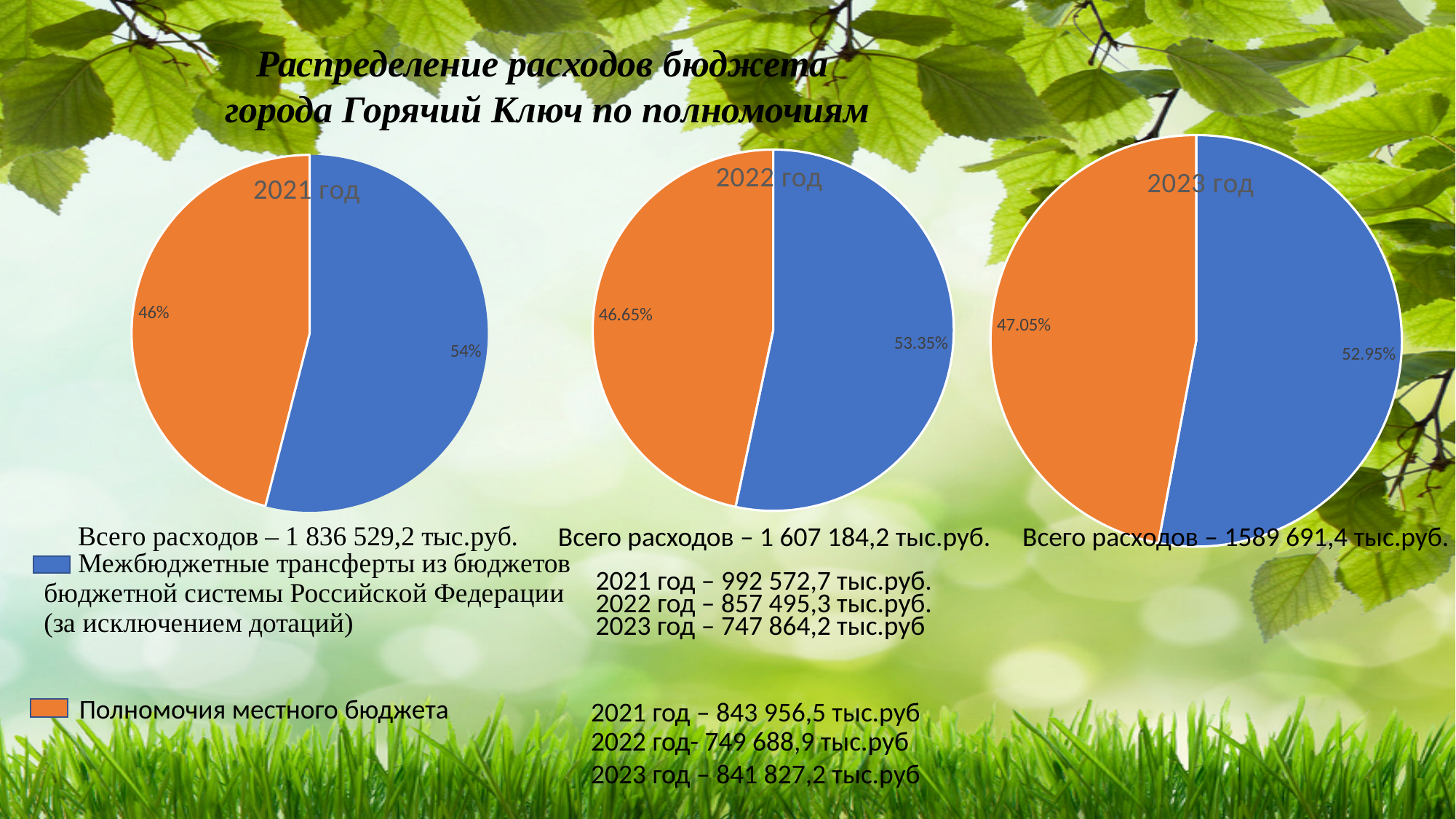
In the "2023 год" chart, what share is shown for the orange slice (Полномочия местного бюджета)? 47.05% In the "2022 год" chart, what share is shown for the orange slice (Полномочия местного бюджета)? 46.65% What kind of chart is used for the "2021 год" chart? pie chart In the "2022 год" chart, what share is shown for the blue slice (Межбюджетные трансферты)? 53.35% In the "2022 год" chart, what is the difference between the blue slice (53.35%) and the orange slice (46.65%)? 6.70% In the "2021 год" chart, what share is shown for the blue slice (Межбюджетные трансферты из бюджетов бюджетной системы Российской Федерации)? 54% In the "2023 год" chart, what share is shown for the blue slice (Межбюджетные трансферты)? 52.95% In the "2021 год" chart, which slice is the largest? Межбюджетные трансферты из бюджетов бюджетной системы Российской Федерации (54%) In the "2023 год" chart, which slice is the smallest? Полномочия местного бюджета (47.05%) How many pie charts are shown on the slide? 3 How many slices does the "2022 год" pie chart have? 2 In the "2021 год" chart, what share is shown for the orange slice (Полномочия местного бюджета)? 46%